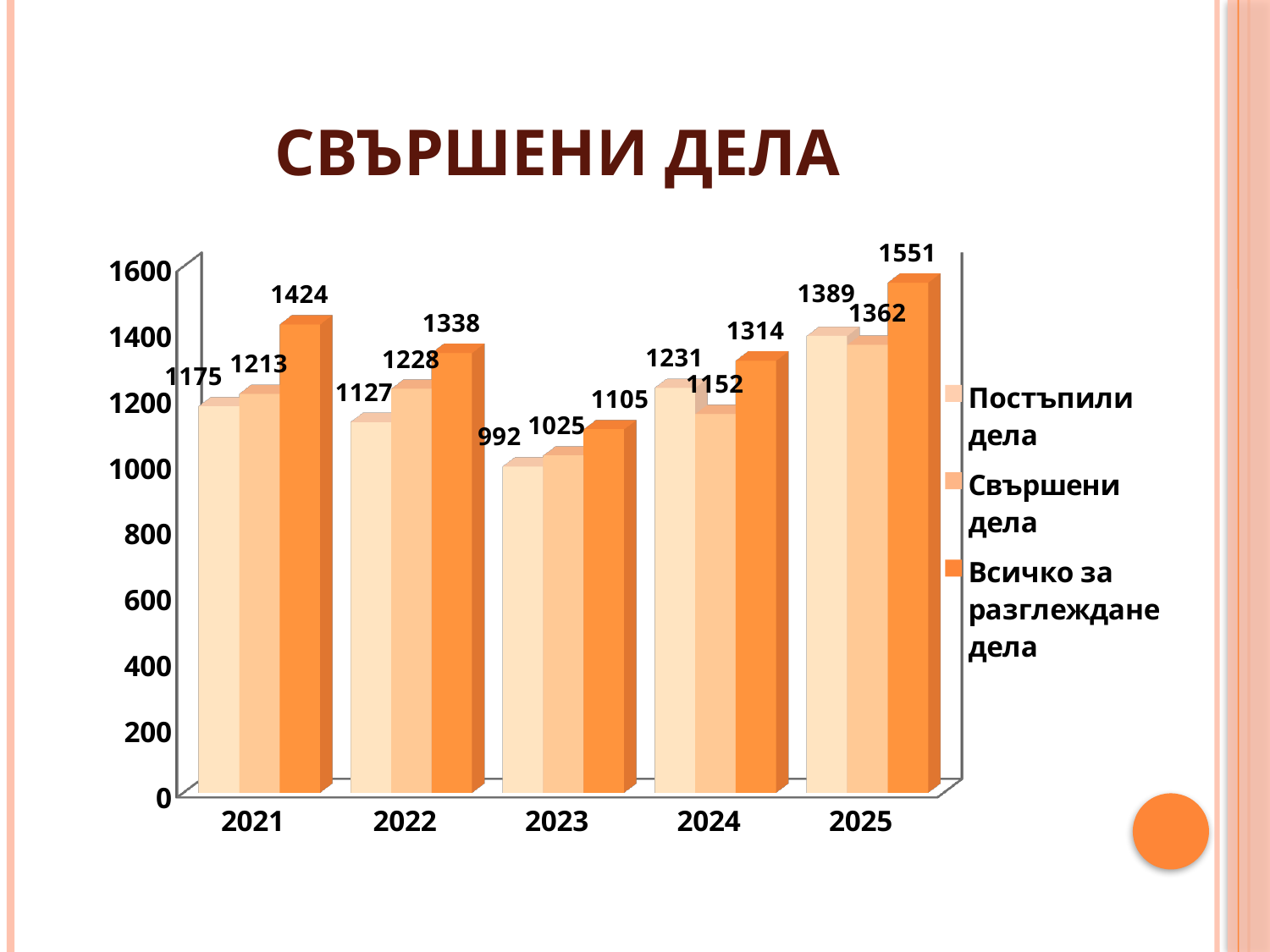
What is the value of Постъпили дела for 2023? 992 What is the title of the slide? СВЪРШЕНИ ДЕЛА How many series does the legend list? 3 What is the difference between Всичко за разглеждане дела and Свършени дела in 2021? 211 What is the value of Свършени дела for 2024? 1152 What is the value of Всичко за разглеждане дела for 2025? 1551 Which year has the highest value for Свършени дела? 2025 Is the value of Постъпили дела for 2025 greater or less than 1200? greater What kind of chart is shown on the slide? bar chart Which year has the lowest value for Всичко за разглеждане дела? 2023 Which is larger in 2022: Постъпили дела or Свършени дела? Свършени дела How many years are shown on the x axis? 5